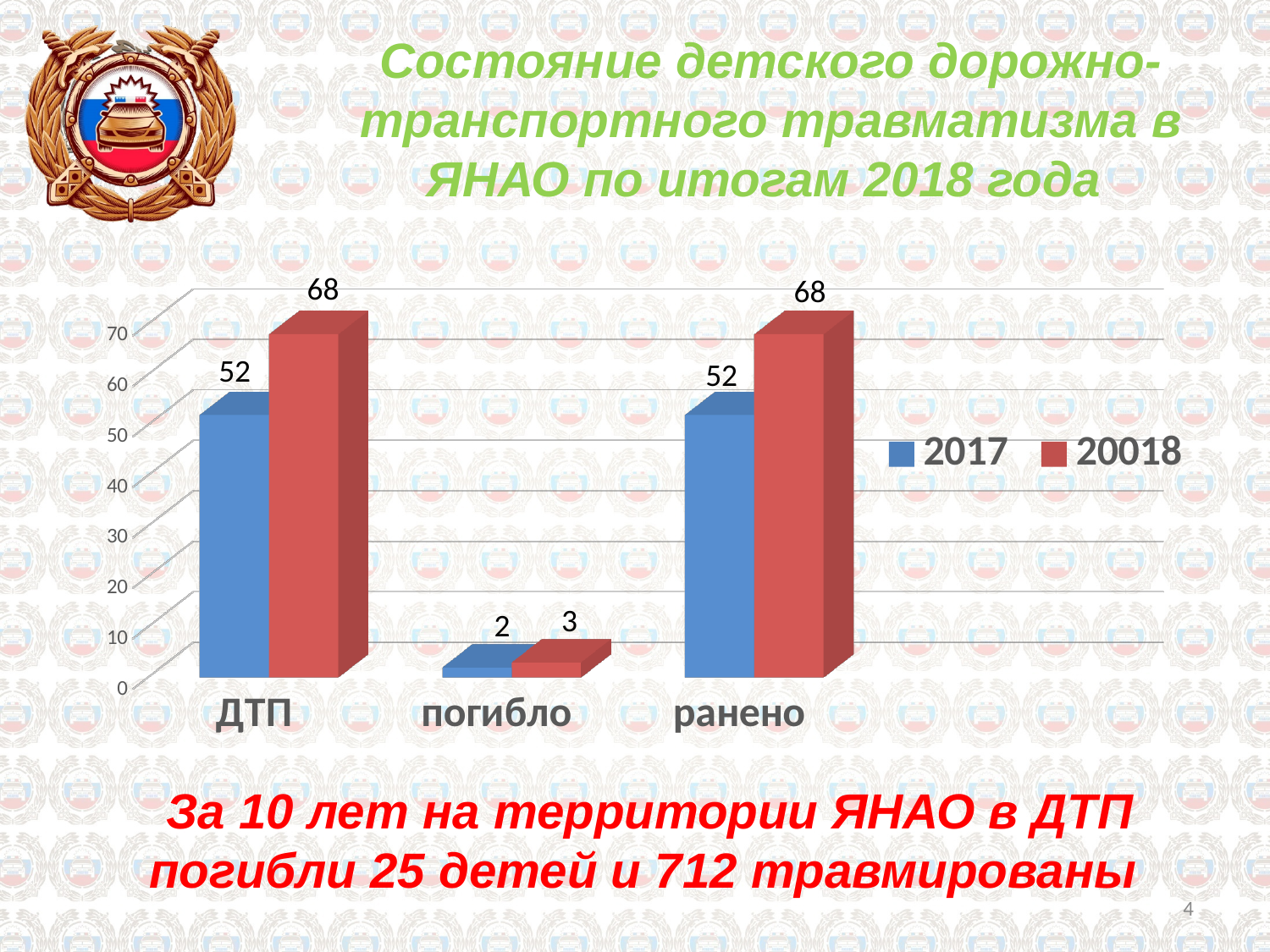
What is the value for ДТП in the 20018 series? 68 Which category has the lowest value in the 2017 series? погибло What is the difference between the 20018 and 2017 values for ДТП? 16 What is the value for ДТП in the 2017 series? 52 Which is larger for ранено: the 2017 value or the 20018 value? 20018 What kind of chart is shown on the slide? bar chart What is the value for погибло in the 2017 series? 2 How many categories are shown on the x axis of the chart? 3 What is the value for погибло in the 20018 series? 3 What is the value for ранено in the 20018 series? 68 How many series does the chart legend list? 2 What colour are the bars for the 2017 series? blue